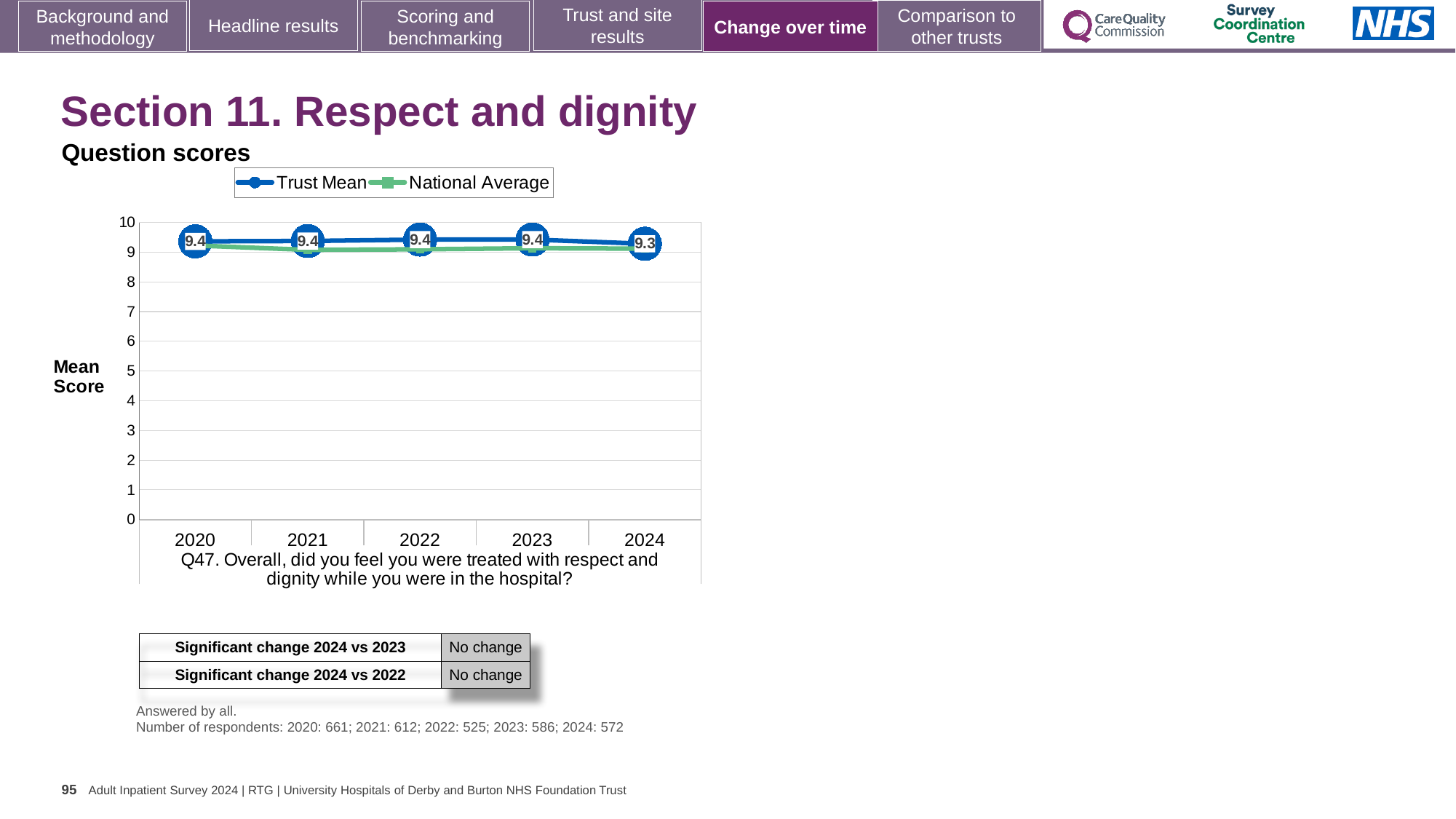
Is the National Average value for 2022 greater or less than 8? greater Which question is the chart about? Q47. Overall, did you feel you were treated with respect and dignity while you were in the hospital? Does the Trust Mean score rise or fall from 2023 to 2024? fall Is the Trust Mean score in 2021 larger or smaller than in 2024? larger Which year has the lowest Trust Mean score? 2024 How many years are shown on the x axis? 5 How many series does the legend list? 2 What is the Trust Mean score for 2024? 9.3 What is the Trust Mean score for 2022? 9.4 What kind of chart is shown? line chart What is the Trust Mean score for 2020? 9.4 What is the difference between the Trust Mean score in 2023 and in 2024? 0.1